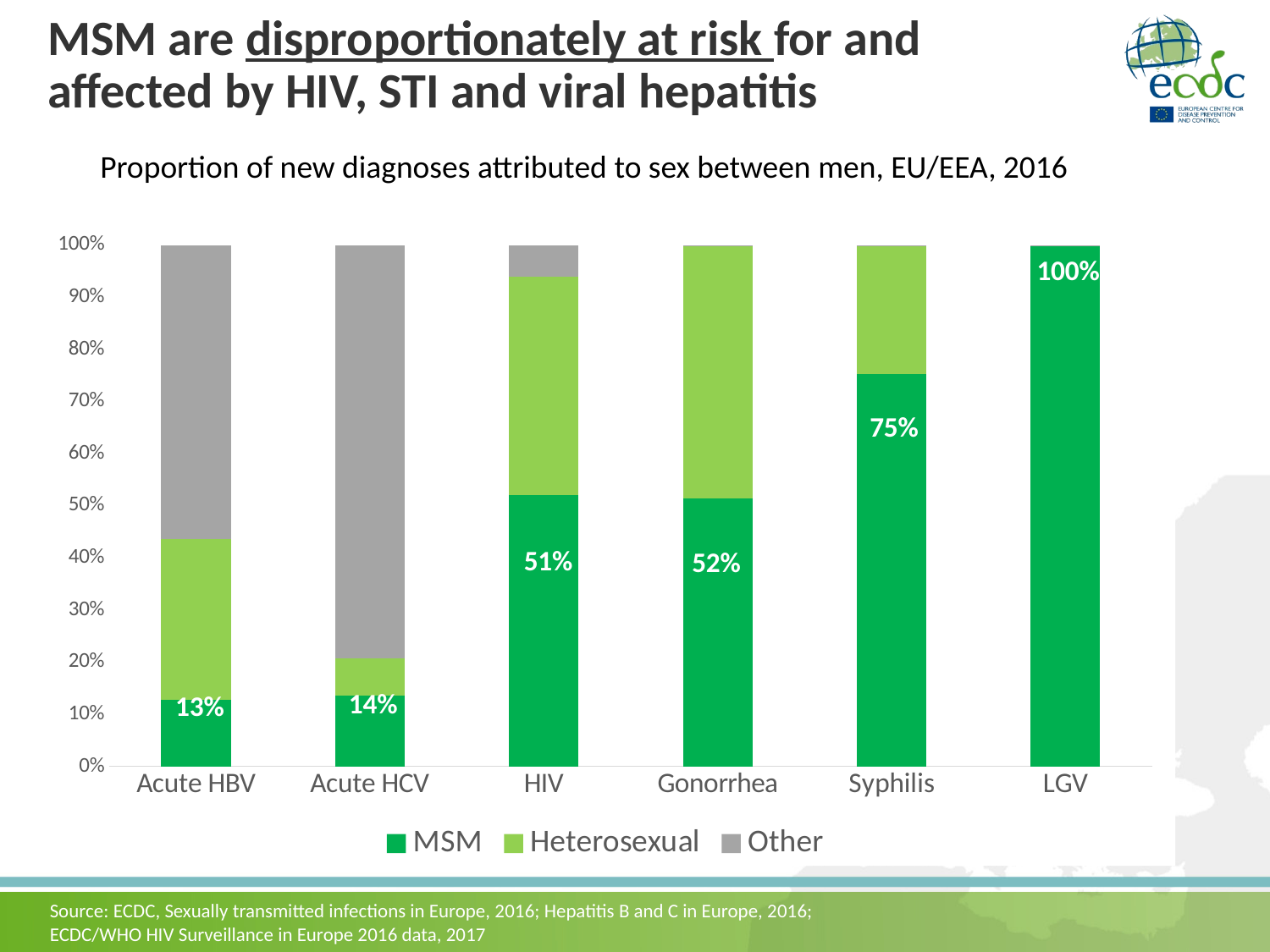
What is the MSM proportion for Syphilis? 75% Which category has the lowest MSM proportion? Acute HBV What is the MSM proportion for Acute HBV? 13% Is the MSM proportion larger for Gonorrhea or for Acute HCV? Gonorrhea What is the title of the chart? Proportion of new diagnoses attributed to sex between men, EU/EEA, 2016 How many categories are shown on the x axis? 6 Is the Other share for Acute HCV greater or less than 70%? greater What is the difference between the MSM proportion for Syphilis and for HIV? 24% What kind of chart is shown? Stacked bar chart Which category has the highest MSM proportion? LGV How many series does the legend list? 3 What is the MSM proportion for HIV? 51%